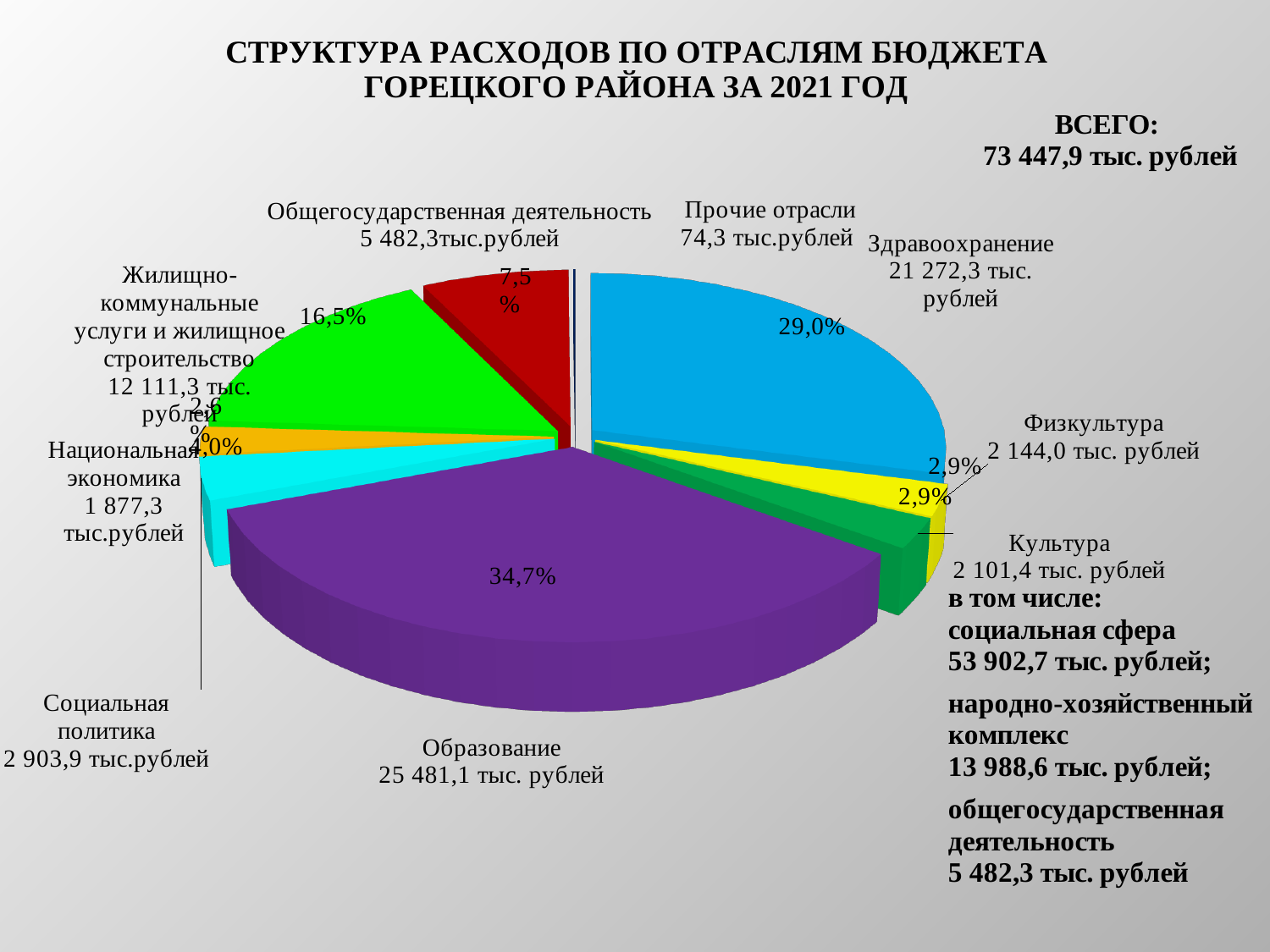
What is the value shown for Здравоохранение? 21 272,3 тыс. рублей How many sectors (slices) are labelled in the pie chart? 9 Which is larger, the value for Физкультура or the value for Культура? Физкультура What share of the pie does Здравоохранение account for? 29,0% Which sector has the smallest expenditure in the chart? Прочие отрасли What is the value shown for Социальная политика? 2 903,9 тыс.рублей What kind of chart is shown on the slide? pie chart What is the difference between the values for Образование and Здравоохранение? 4 208,8 тыс. рублей What share of the pie does Образование account for? 34,7% Which sector has the largest expenditure in the chart? Образование What share of the pie does Общегосударственная деятельность account for? 7,5%